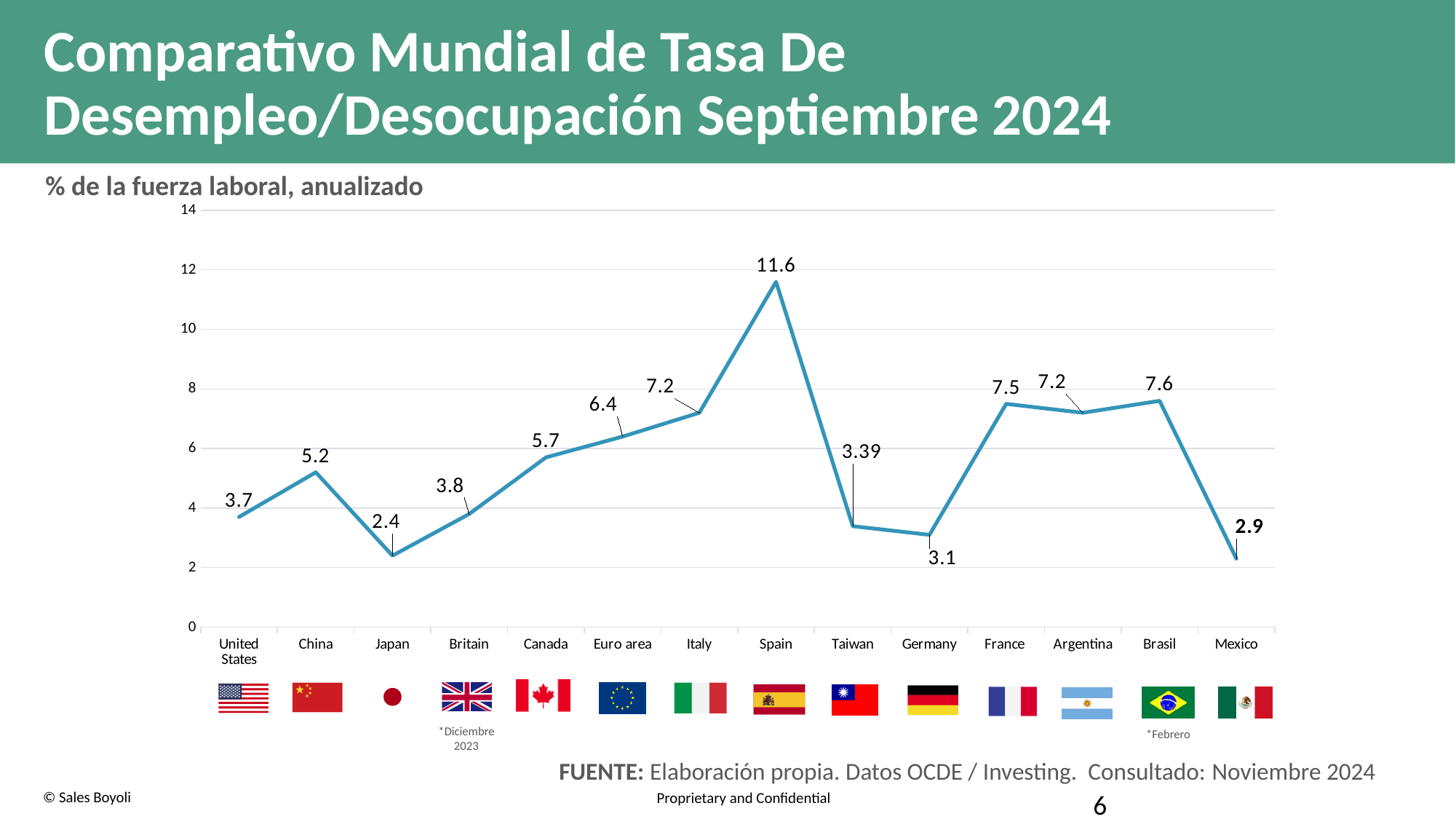
What is the unemployment rate shown for Spain? 11.6 What is the value shown for Taiwan? 3.39 Do the values rise or fall along the x axis from Japan to Spain? rise What is the value shown for Mexico? 2.9 What is the difference between the values for Spain and Japan? 9.2 What is the difference between the values for France and Germany? 4.4 Is the value for Spain greater or less than 10? greater Which has a higher value, Canada or China? Canada What type of chart is shown on the slide? line chart How many countries or regions are plotted on the chart? 14 Which country has the highest unemployment rate on the chart? Spain